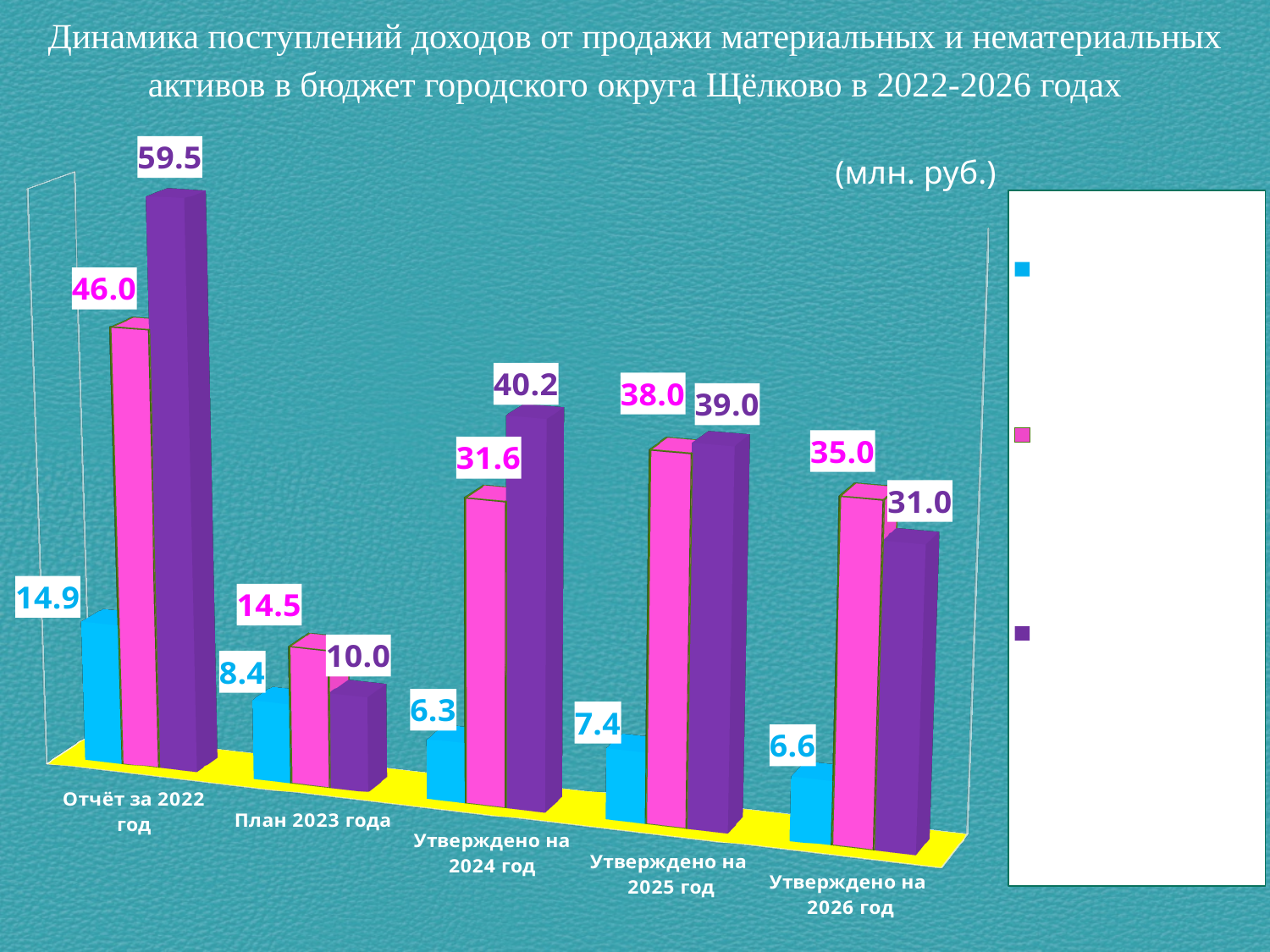
How many categories are shown on the x axis? 5 What kind of chart is shown on the slide? bar chart What is the value of the purple bar for "Отчёт за 2022 год"? 59.5 In what units are the values on the chart given? млн. руб. How many series does the legend list? 3 What is the value of the blue bar for "План 2023 года"? 8.4 What is the value of the pink bar for "Утверждено на 2025 год"? 38.0 Do the blue bars rise or fall from "Отчёт за 2022 год" to "Утверждено на 2024 год"? fall Which category has the lowest blue bar? Утверждено на 2024 год For "Утверждено на 2026 год", which is larger: the pink bar or the purple bar? the pink bar Which category has the highest purple bar? Отчёт за 2022 год What is the difference between the purple and pink bars for "Отчёт за 2022 год"? 13.5